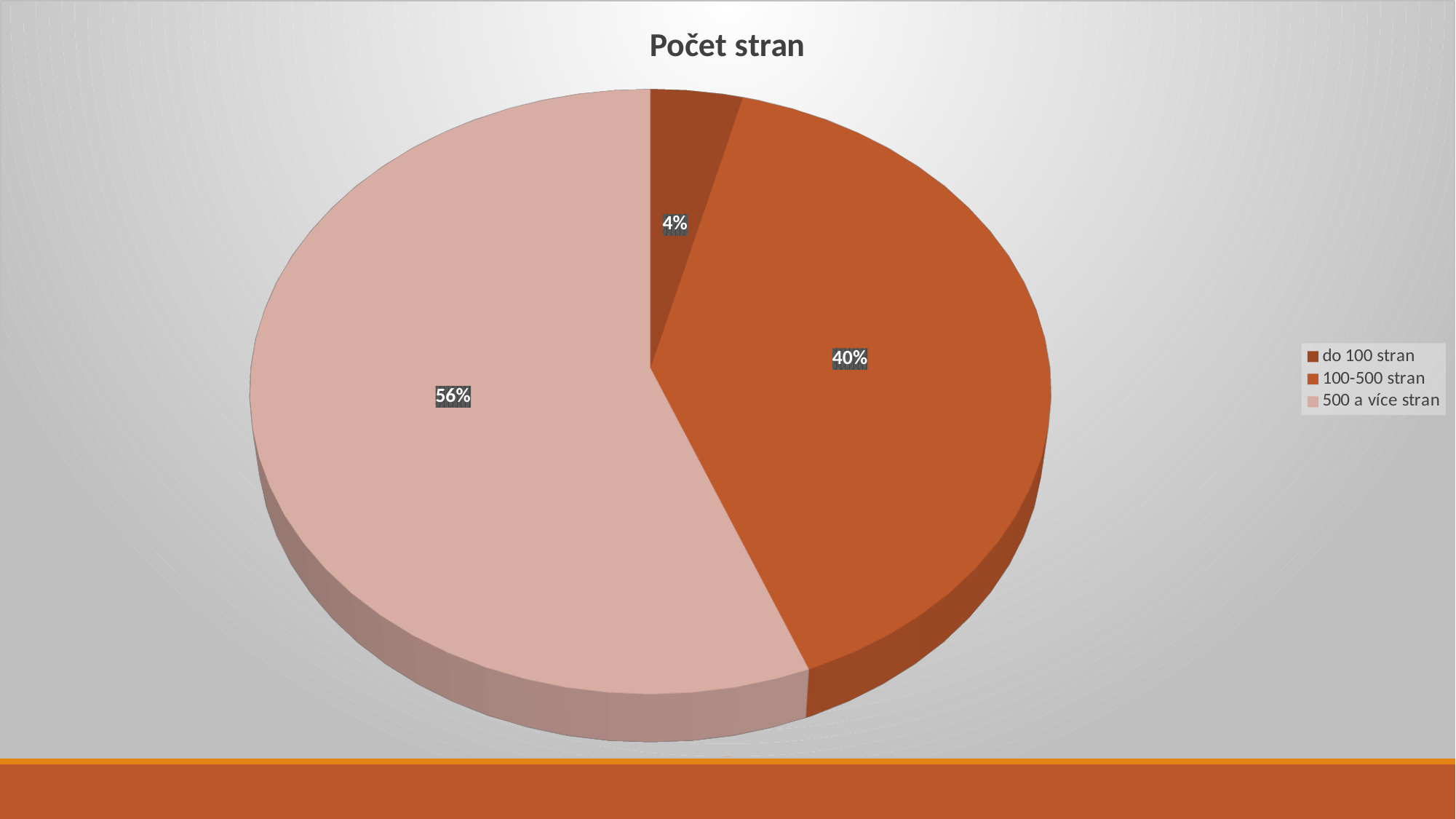
Which legend entry is shown in the lightest (pale pink) colour? 500 a více stran What is the title of the chart? Počet stran Which category has the smallest slice of the pie? do 100 stran What share of the pie does the '500 a více stran' slice represent? 56% Which slice is larger: '100-500 stran' or 'do 100 stran'? 100-500 stran What share of the pie does the 'do 100 stran' slice represent? 4% What is the difference in percentage points between the '500 a více stran' slice and the '100-500 stran' slice? 16 What share of the pie does the '100-500 stran' slice represent? 40% What is the difference in percentage points between the '100-500 stran' slice and the 'do 100 stran' slice? 36 What kind of chart is shown on the slide? pie chart Which category has the largest slice of the pie? 500 a více stran How many categories does the pie chart show? 3